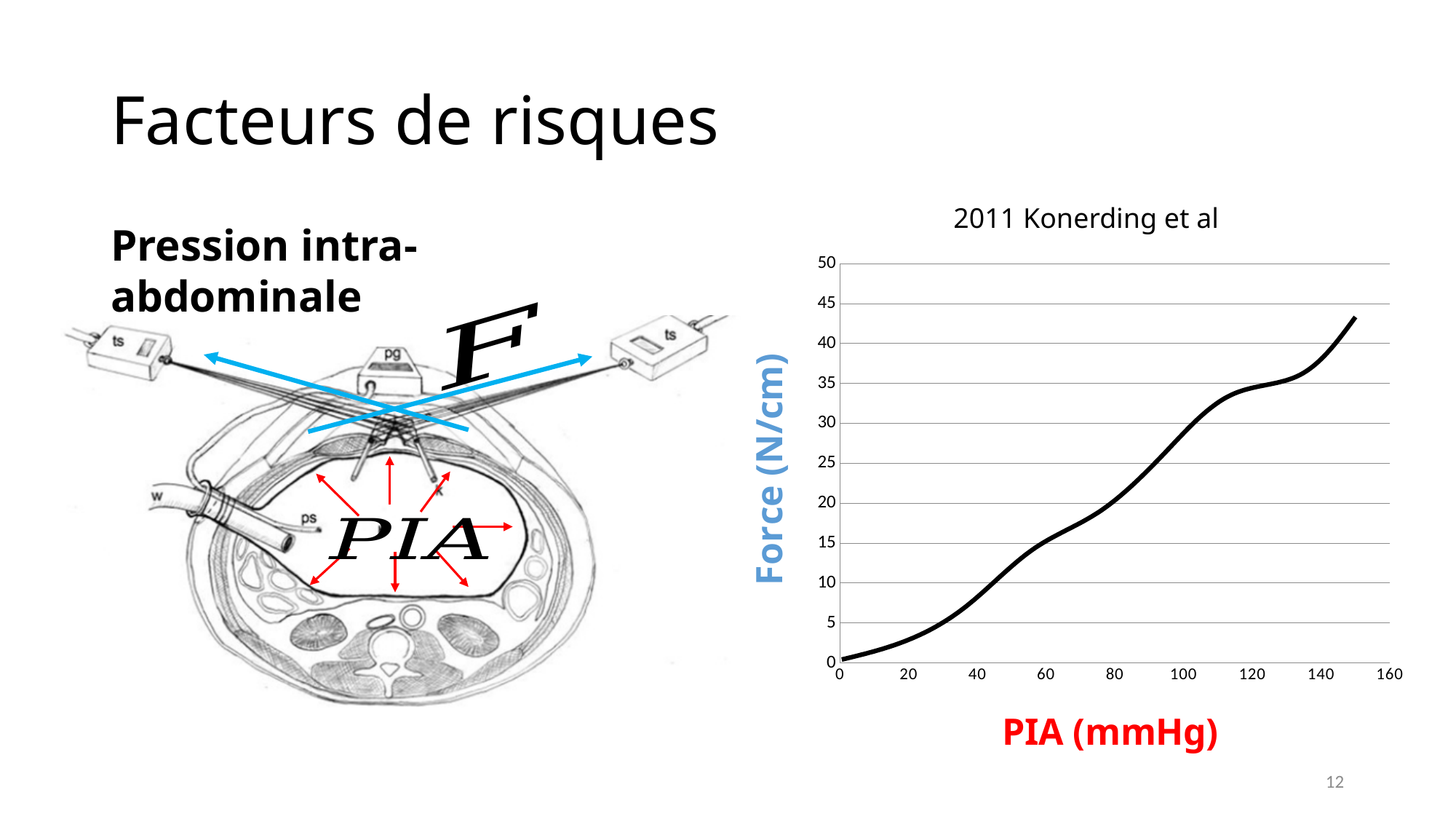
Is the highest force reached on the curve greater or less than 40 N/cm? greater Is the force at a PIA of 20 mmHg greater or less than 5 N/cm? less Does the force rise or fall as PIA increases along the x axis? rise Is the force at a PIA of 40 mmHg greater or less than 10 N/cm? less What is the title of the chart on the right? 2011 Konerding et al Is the force at a PIA of 100 mmHg larger or smaller than the force at a PIA of 60 mmHg? larger What is the maximum value shown on the y axis of the chart? 50 What kind of chart is shown on the right of the slide? line chart What is the label of the y axis of the chart? Force (N/cm)